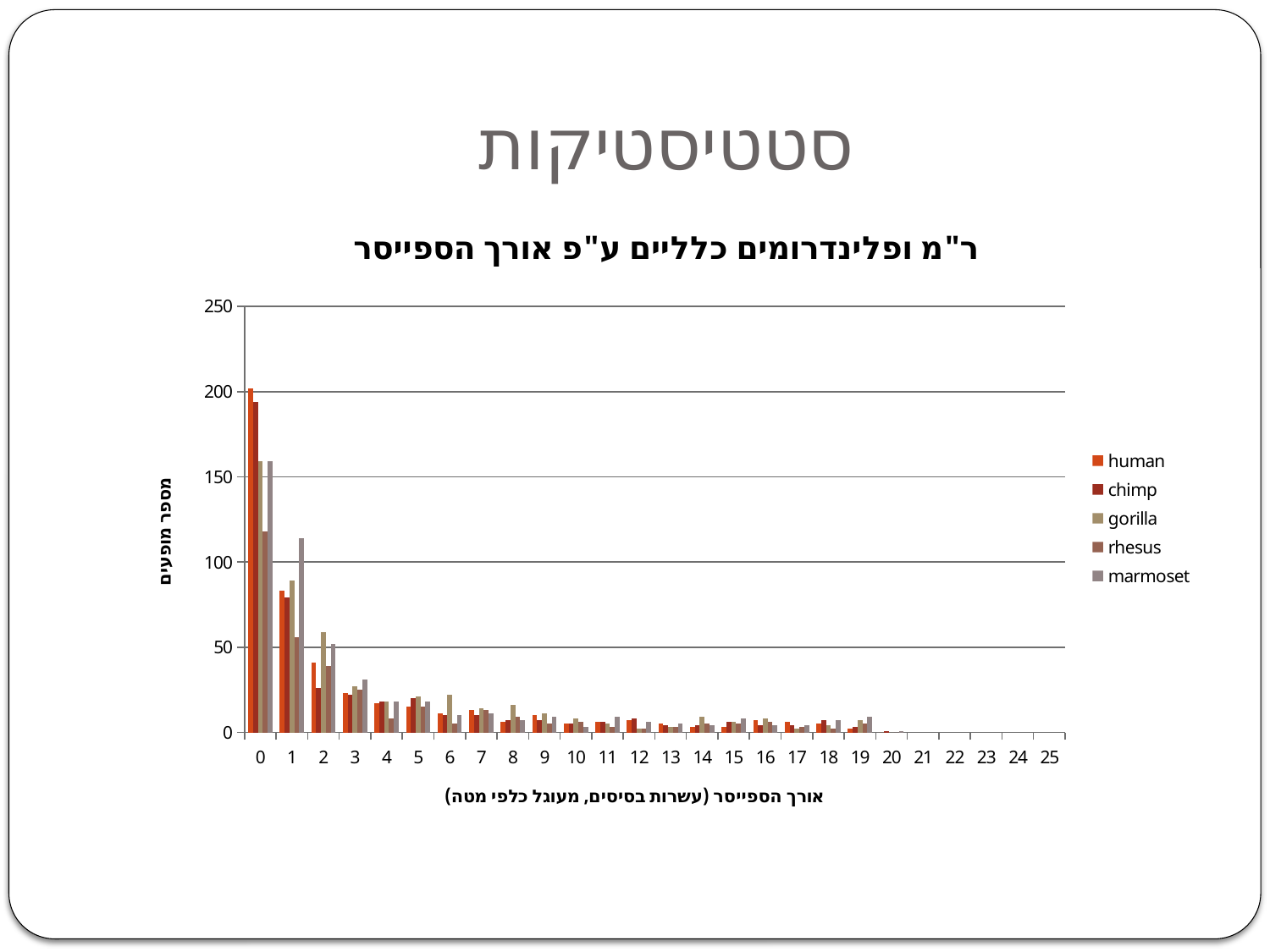
How many series does the legend list? 5 What kind of chart is shown on the slide? bar chart At which spacer length do all series reach their highest values? 0 At spacer length 2, which is larger: the value for gorilla or the value for chimp? gorilla Is the value for human at spacer length 0 greater or less than 150? greater Do the values generally rise or fall as the spacer length increases along the x axis? fall Is the value for rhesus at spacer length 0 greater or less than 150? less How many spacer-length categories are shown along the x axis? 26 Which series has the highest value at spacer length 0? human Is the value for human at spacer length 2 greater or less than 50? less At spacer length 1, which is larger: the value for marmoset or the value for chimp? marmoset